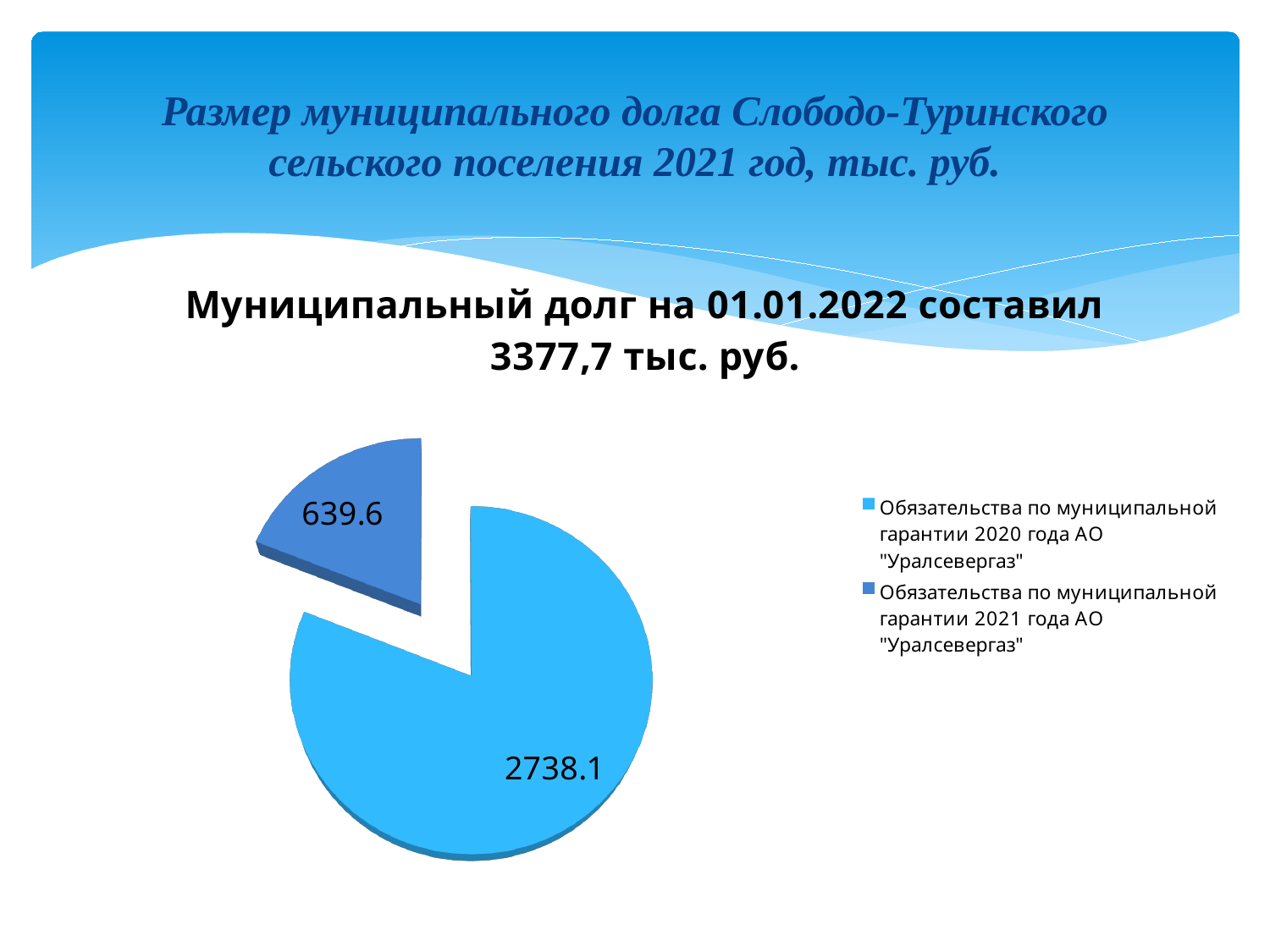
What is the total of the two slices in the pie chart? 3377.7 What type of chart is shown on the slide? Pie chart Which category has the smallest slice of the pie? Обязательства по муниципальной гарантии 2021 года АО "Уралсевергаз" How many slices does the pie chart have? 2 What share of the pie does the 2021 guarantee obligations slice represent? 18.9% How many entries does the legend list? 2 According to the slide text, what was the municipal debt as of 01.01.2022? 3377,7 тыс. руб. Which category has the largest slice of the pie? Обязательства по муниципальной гарантии 2020 года АО "Уралсевергаз" What is the difference between the 2020 guarantee obligations and the 2021 guarantee obligations? 2098.5 What is the value for 'Обязательства по муниципальной гарантии 2020 года АО "Уралсевергаз"'? 2738.1 What is the value for 'Обязательства по муниципальной гарантии 2021 года АО "Уралсевергаз"'? 639.6 Which is larger: the 2020 guarantee obligations or the 2021 guarantee obligations? 2020 guarantee obligations